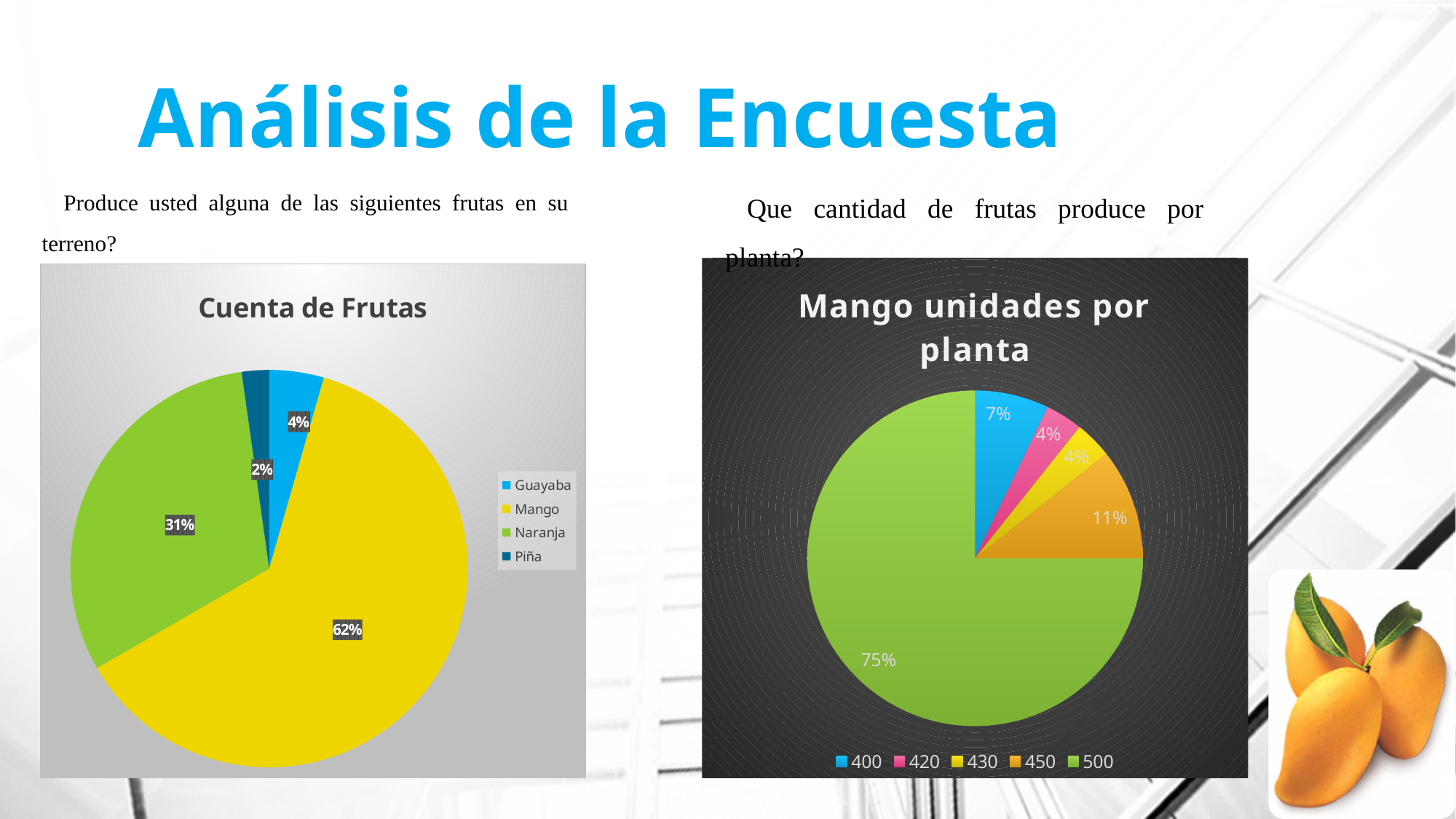
In the 'Mango unidades por planta' chart, which category has the largest slice? 500 In the 'Cuenta de Frutas' chart, what share of the pie does Mango have? 62% In the 'Mango unidades por planta' chart, what share of the pie does the 450 category have? 11% In the 'Cuenta de Frutas' chart, what is the difference in percentage points between Mango and Naranja? 31 In the 'Cuenta de Frutas' chart, which fruit has the largest slice? Mango In the 'Mango unidades por planta' chart, what share of the pie does the 500 category have? 75% In the 'Cuenta de Frutas' chart, how many fruit categories are shown? 4 What kind of chart is 'Mango unidades por planta'? Pie chart In the 'Cuenta de Frutas' chart, which fruit has the smallest slice? Piña In the 'Mango unidades por planta' chart, which is larger, the slice for 400 or the slice for 450? 450 In the 'Mango unidades por planta' chart, how many categories does the legend list? 5